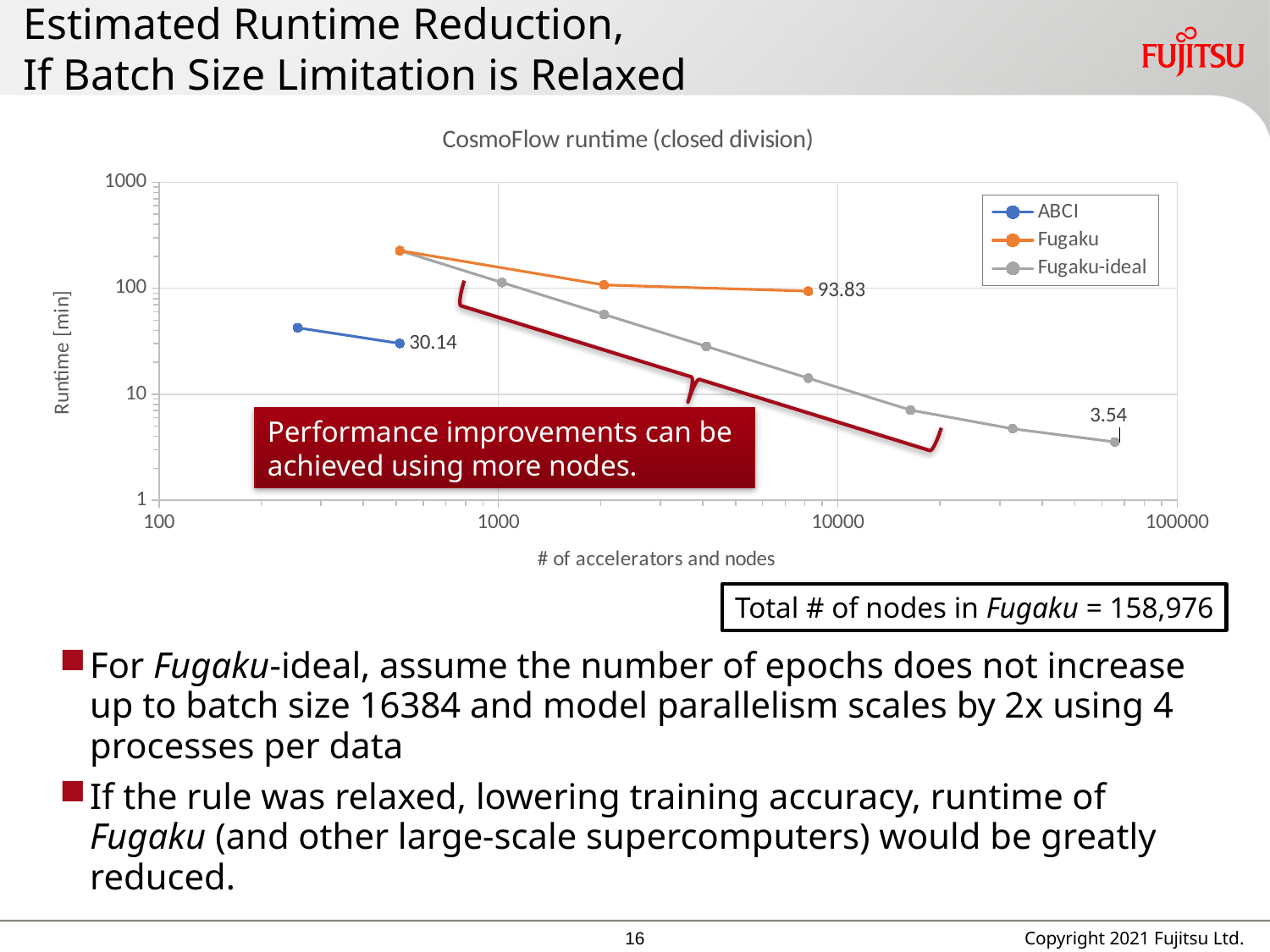
Which is larger, the labeled final runtime of Fugaku or of ABCI? Fugaku What kind of chart is shown on the slide? line chart What is the title of the chart? CosmoFlow runtime (closed division) How many data points does the Fugaku series have? 3 What is the labeled runtime at the last point of the ABCI series? 30.14 What is the labeled runtime at the last point of the Fugaku series? 93.83 What is the difference between the labeled final runtime of Fugaku (93.83) and of ABCI (30.14)? 63.69 How many series does the legend list? 3 What is the labeled runtime at the last point of the Fugaku-ideal series? 3.54 Does the Fugaku-ideal runtime rise or fall as the number of accelerators and nodes increases? fall Which series has the lowest labeled runtime value? Fugaku-ideal Is the runtime of the first Fugaku point greater or less than 100 minutes? greater